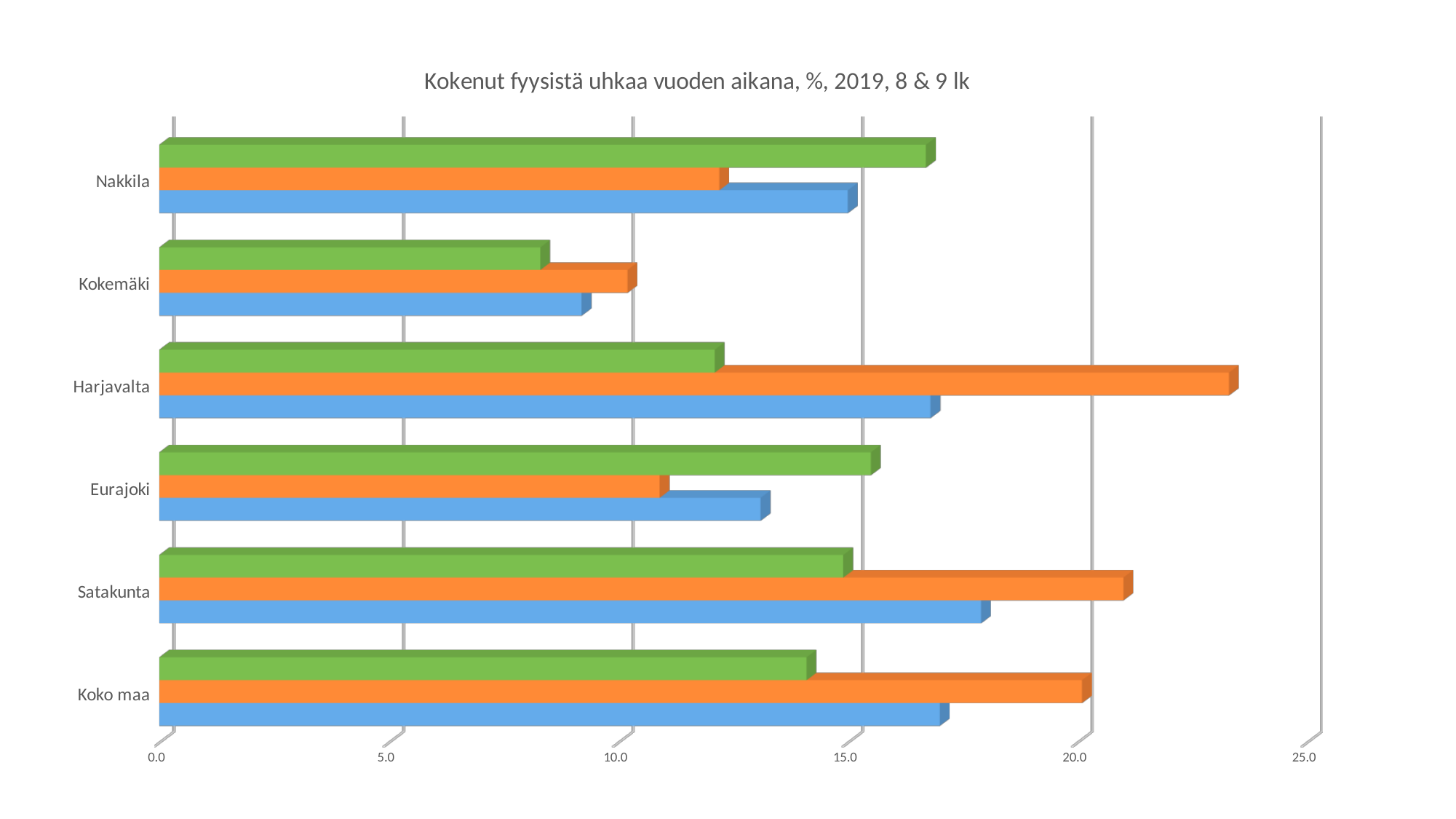
Is the green bar for Kokemäki greater or less than 10? less What is the title of the chart? Kokenut fyysistä uhkaa vuoden aikana, %, 2019, 8 & 9 lk Which category has the longest blue bar? Satakunta How many bars are shown for each category in the chart? 3 Is the green bar for Koko maa greater or less than 15? less What kind of chart is shown on the slide? bar chart Which category has the shortest green bar? Kokemäki Which category has the longest orange bar? Harjavalta How many categories are shown on the vertical axis of the chart? 6 Is the orange bar for Harjavalta greater or less than 20? greater Which is longer, the orange bar for Harjavalta or the orange bar for Nakkila? Harjavalta